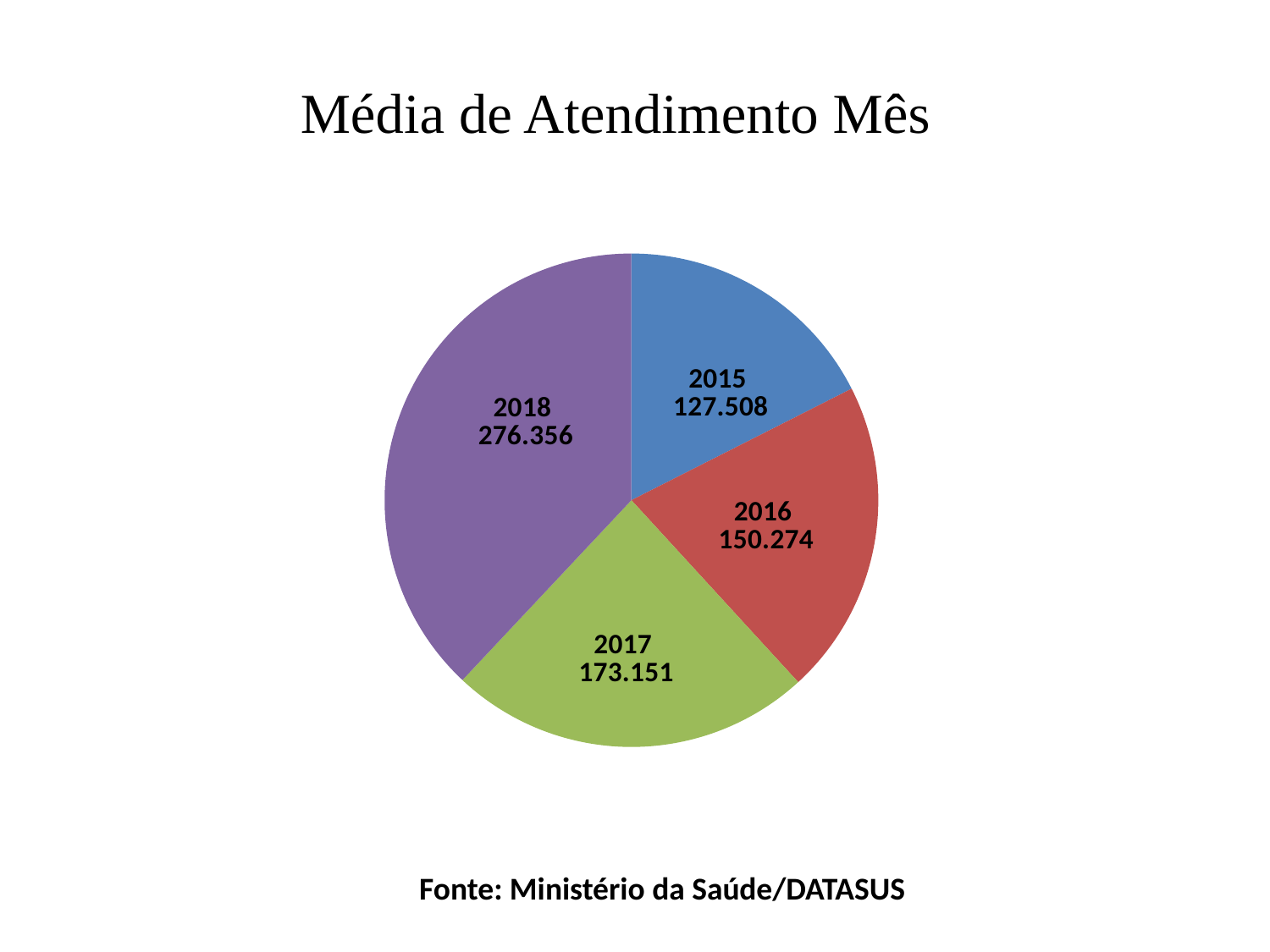
Which year has the largest slice of the pie? 2018 What is the value shown for 2016? 150.274 How many slices does the pie chart have? 4 What source is cited below the chart? Ministério da Saúde/DATASUS What is the value shown for 2015? 127.508 What is the difference between the values for 2018 and 2015? 148.848 Which is larger, the value for 2016 or the value for 2017? 2017 What is the title of the chart? Média de Atendimento Mês What is the value shown for 2018? 276.356 What type of chart is shown on the slide? pie chart Which year has the smallest slice of the pie? 2015 What is the value shown for 2017? 173.151